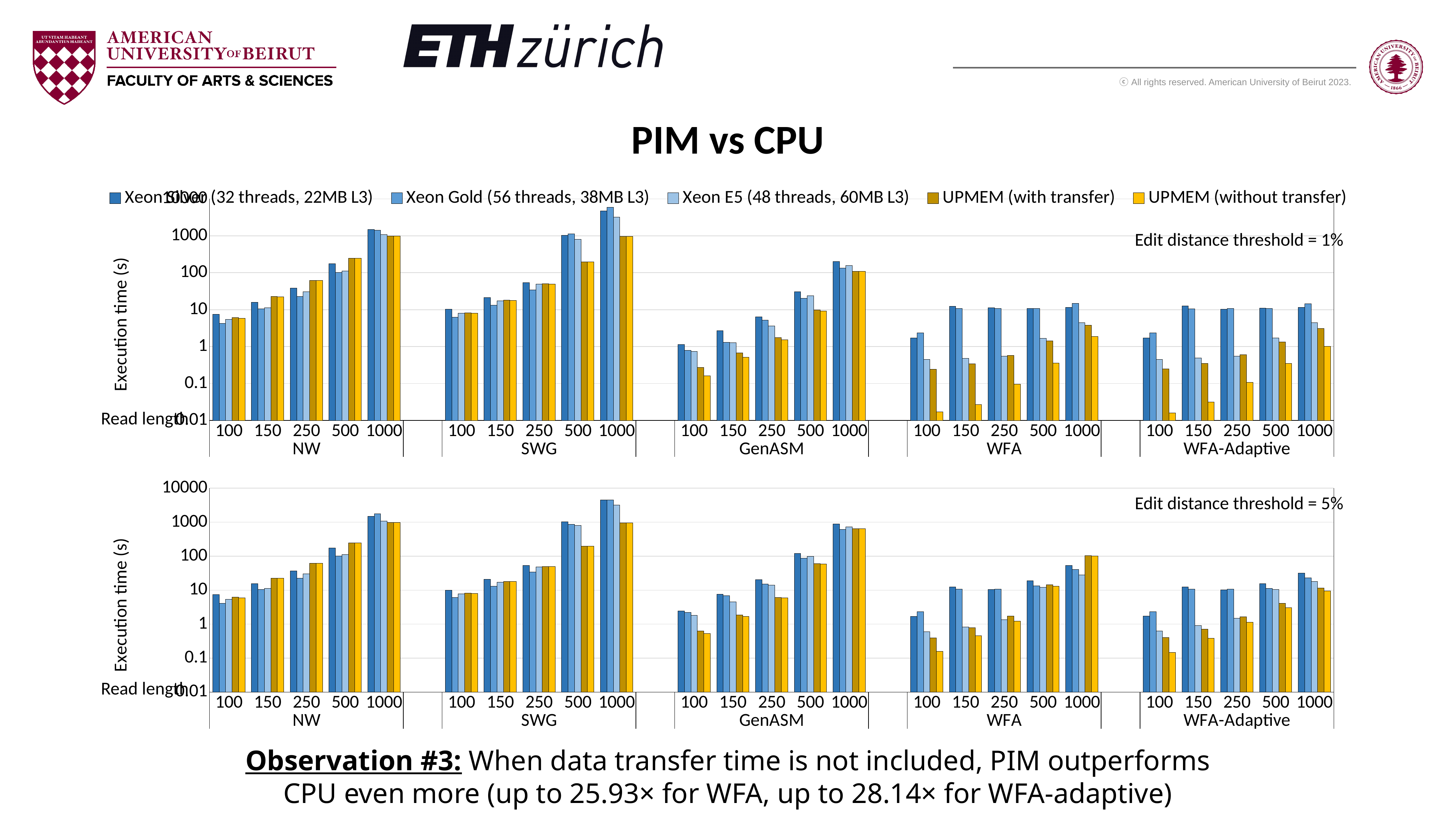
In the top chart (Edit distance threshold = 1%), which series has the lowest value for WFA at read length 100? UPMEM (without transfer) How many series does the legend list? 5 In the bottom chart (Edit distance threshold = 5%), which is larger for WFA at read length 1000: Xeon Silver or UPMEM (with transfer)? UPMEM (with transfer) In the top chart (Edit distance threshold = 1%), is the Xeon Silver value for NW at read length 1000 greater or less than 1000? greater What is the title of the slide's charts? PIM vs CPU In the top chart (Edit distance threshold = 1%), is the UPMEM (without transfer) value for WFA at read length 100 greater or less than 0.1? less In the top chart (Edit distance threshold = 1%), which is larger for WFA at read length 100: Xeon Silver or UPMEM (without transfer)? Xeon Silver What kind of chart is the top chart (Edit distance threshold = 1%)? bar chart In the bottom chart (Edit distance threshold = 5%), does the Xeon Silver execution time for NW rise or fall as read length increases from 100 to 1000? rise What is the y-axis label of the charts? Execution time (s) In the bottom chart (Edit distance threshold = 5%), is the UPMEM (with transfer) value for SWG at read length 500 greater or less than 100? greater How many algorithm groups are shown along the x axis of the bottom chart (Edit distance threshold = 5%)? 5